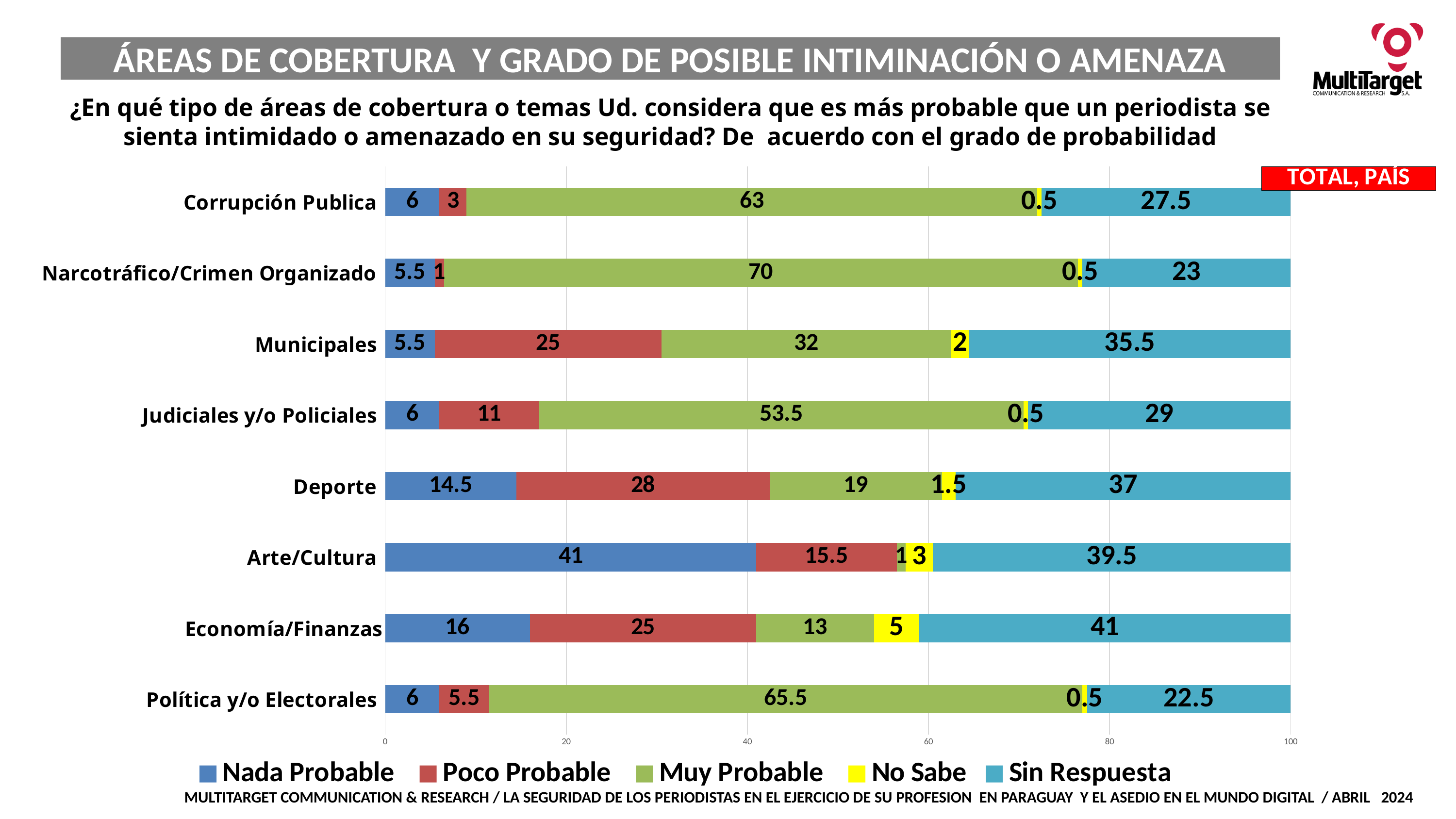
Which is larger, the Poco Probable value for Deporte or for Economía/Finanzas? Deporte Which category has the highest Muy Probable value? Narcotráfico/Crimen Organizado What is the total of the stacked bar for Deporte? 100 What is the Muy Probable value for Narcotráfico/Crimen Organizado? 70 What is the difference between the Muy Probable values for Corrupción Publica and Municipales? 31 Which category has the lowest Muy Probable value? Arte/Cultura What kind of chart is shown on the slide? Stacked bar chart What is the Nada Probable value for Arte/Cultura? 41 What is the No Sabe value for Municipales? 2 How many categories are shown on the chart? 8 How many series does the legend list? 5 What is the Sin Respuesta value for Economía/Finanzas? 41